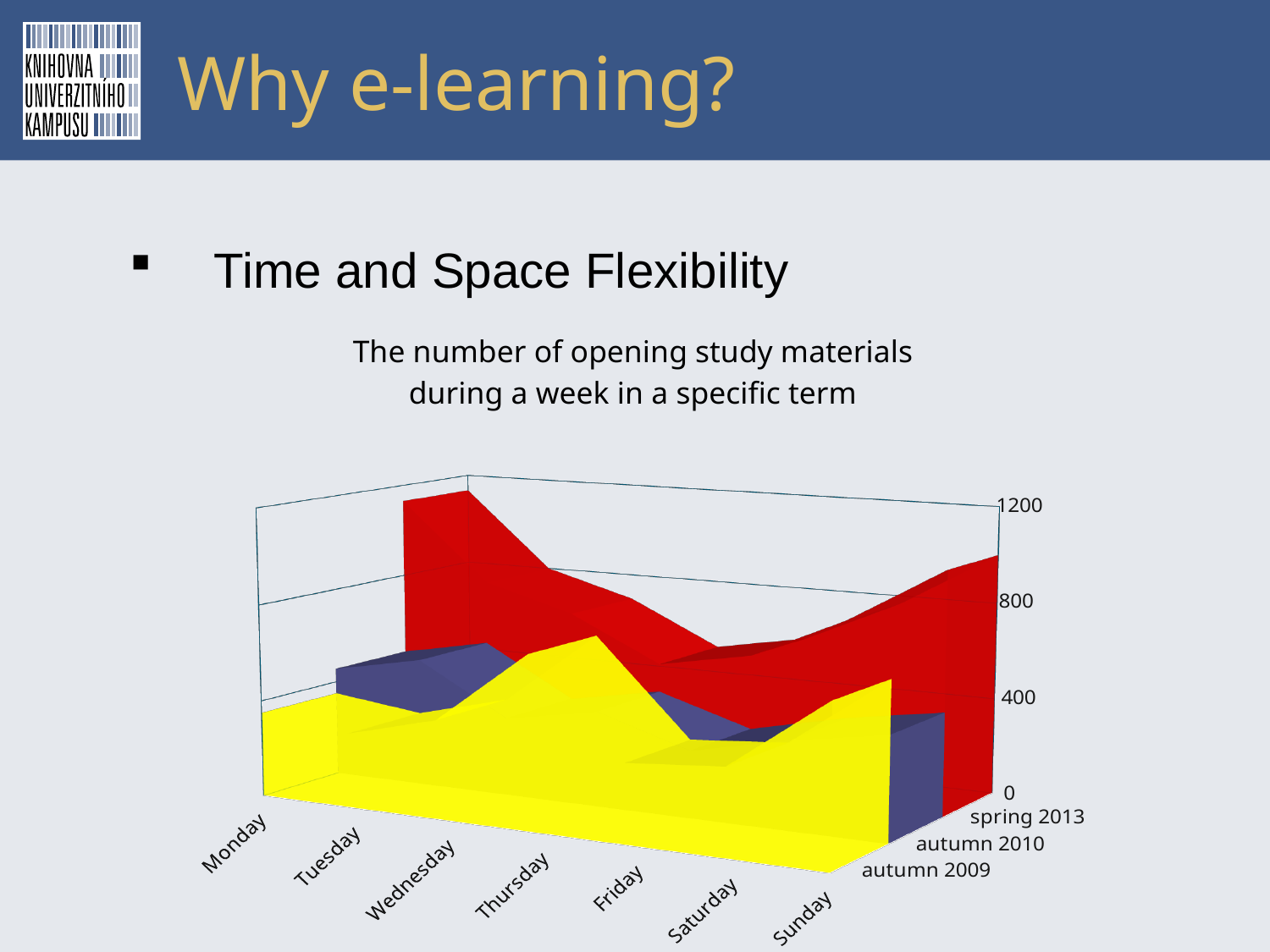
How many days of the week are shown along the x axis of the chart? 7 Does the spring 2013 series rise or fall from Monday to Wednesday? fall On which day does the autumn 2009 series reach its highest value? Thursday On which day does the spring 2013 series reach its highest value? Monday How many terms (series) are plotted in the chart? 3 What is the title of the chart? The number of opening study materials during a week in a specific term Is the value for spring 2013 on Monday greater or less than 800? greater Does the spring 2013 series rise or fall from Friday to Sunday? rise Which is larger on Monday: the value for spring 2013 or the value for autumn 2009? spring 2013 What is the highest value shown on the vertical axis of the chart? 1200 What kind of chart is shown on the slide? area chart Which term has the highest value on Monday? spring 2013